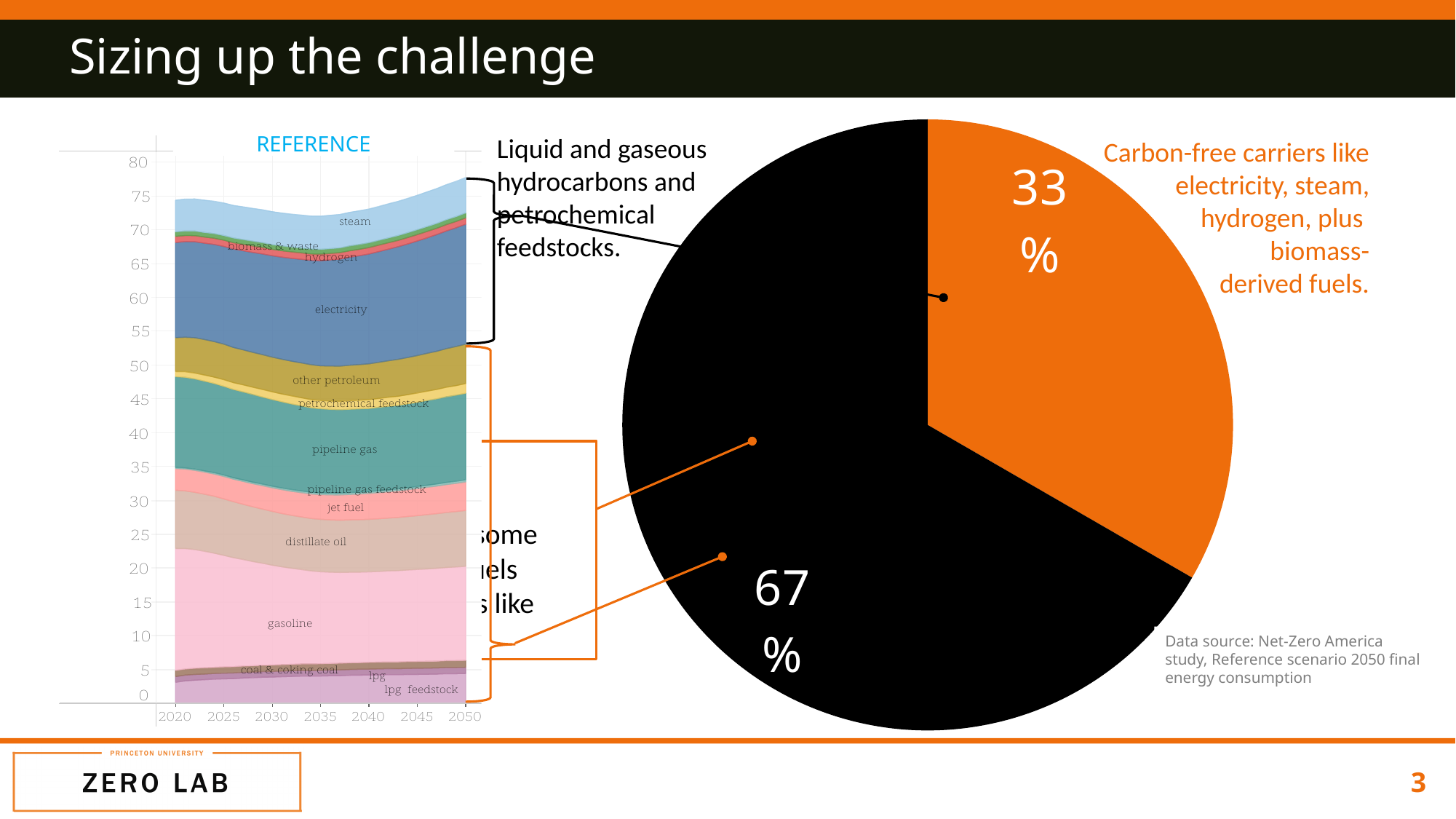
How many slices does the pie chart on the right have? 2 On the REFERENCE chart, which labelled area is at the bottom of the stack? lpg feedstock On the pie chart, what is the difference in percentage points between the 67% slice and the 33% slice? 34 percentage points On the REFERENCE chart, how many year labels are shown along the x axis? 7 On the REFERENCE chart, which labelled area is at the top of the stack? steam On the REFERENCE chart, is the total stacked value in 2020 greater or less than 70? greater On the pie chart, what share is shown for the black slice representing liquid and gaseous hydrocarbons and petrochemical feedstocks? 67% On the pie chart, which slice is larger, the orange carbon-free carriers slice or the black hydrocarbons slice? the black hydrocarbons slice What kind of chart is the REFERENCE chart on the left side of the slide? stacked area chart What kind of chart is the chart on the right side of the slide? pie chart On the pie chart, what share is shown for the orange slice representing carbon-free carriers? 33% On the REFERENCE chart, is the total stacked value in 2050 greater or less than 75? greater